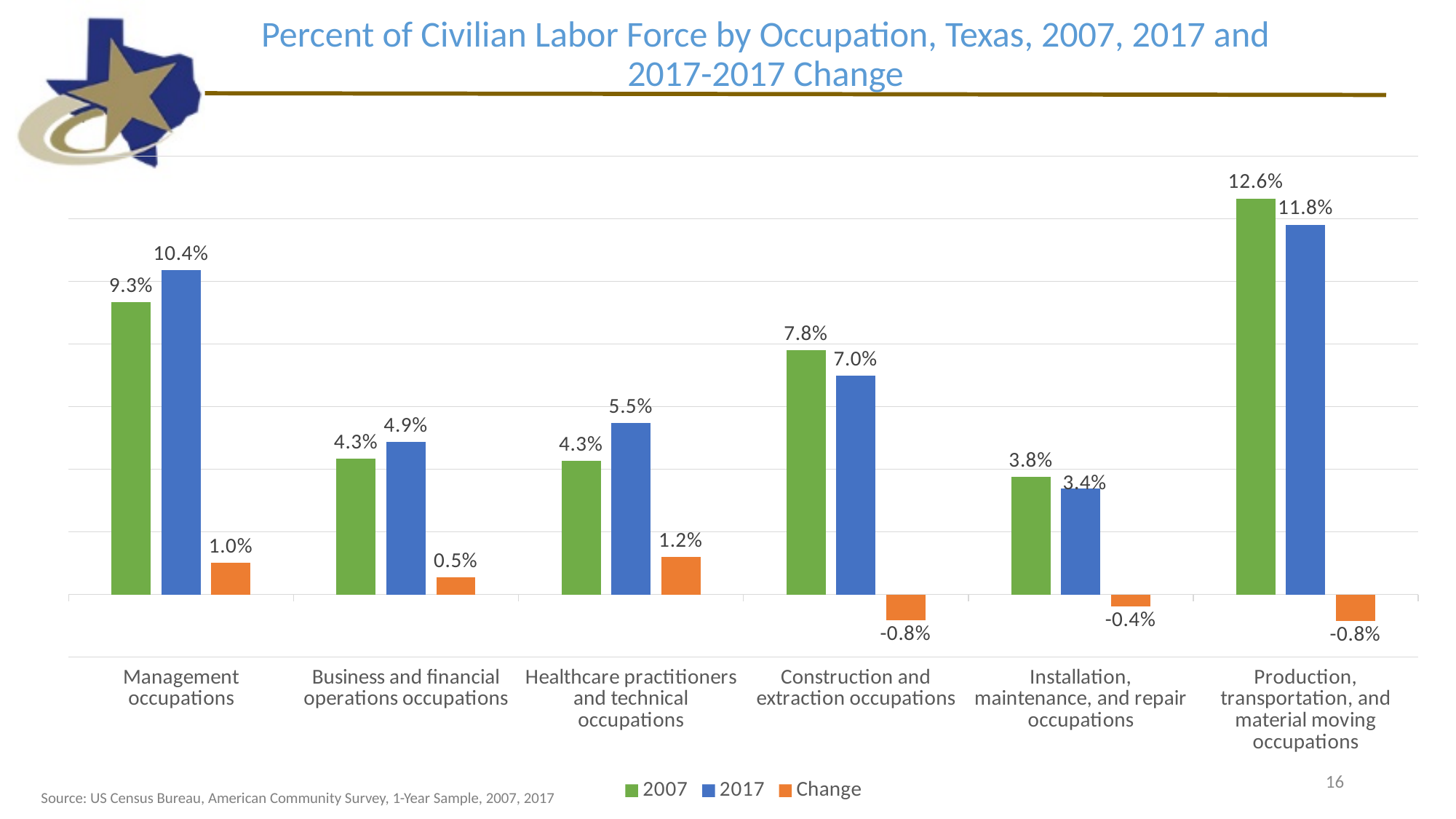
What is the Change value for Installation, maintenance, and repair occupations? -0.4% What was the 2017 value for Management occupations? 10.4% How many occupation categories are shown on the chart? 6 Which occupation has the highest 2007 value? Production, transportation, and material moving occupations What kind of chart is shown on the slide? Bar chart Which occupation has the lowest 2017 value? Installation, maintenance, and repair occupations What was the 2007 value for Construction and extraction occupations? 7.8% How many series does the legend list? 3 What is the difference between the 2007 and 2017 values for Production, transportation, and material moving occupations? 0.8% Which is larger for Business and financial operations occupations, the 2007 value or the 2017 value? 2017 Which colour represents the Change series in the chart? Orange What is the Change value for Healthcare practitioners and technical occupations? 1.2%